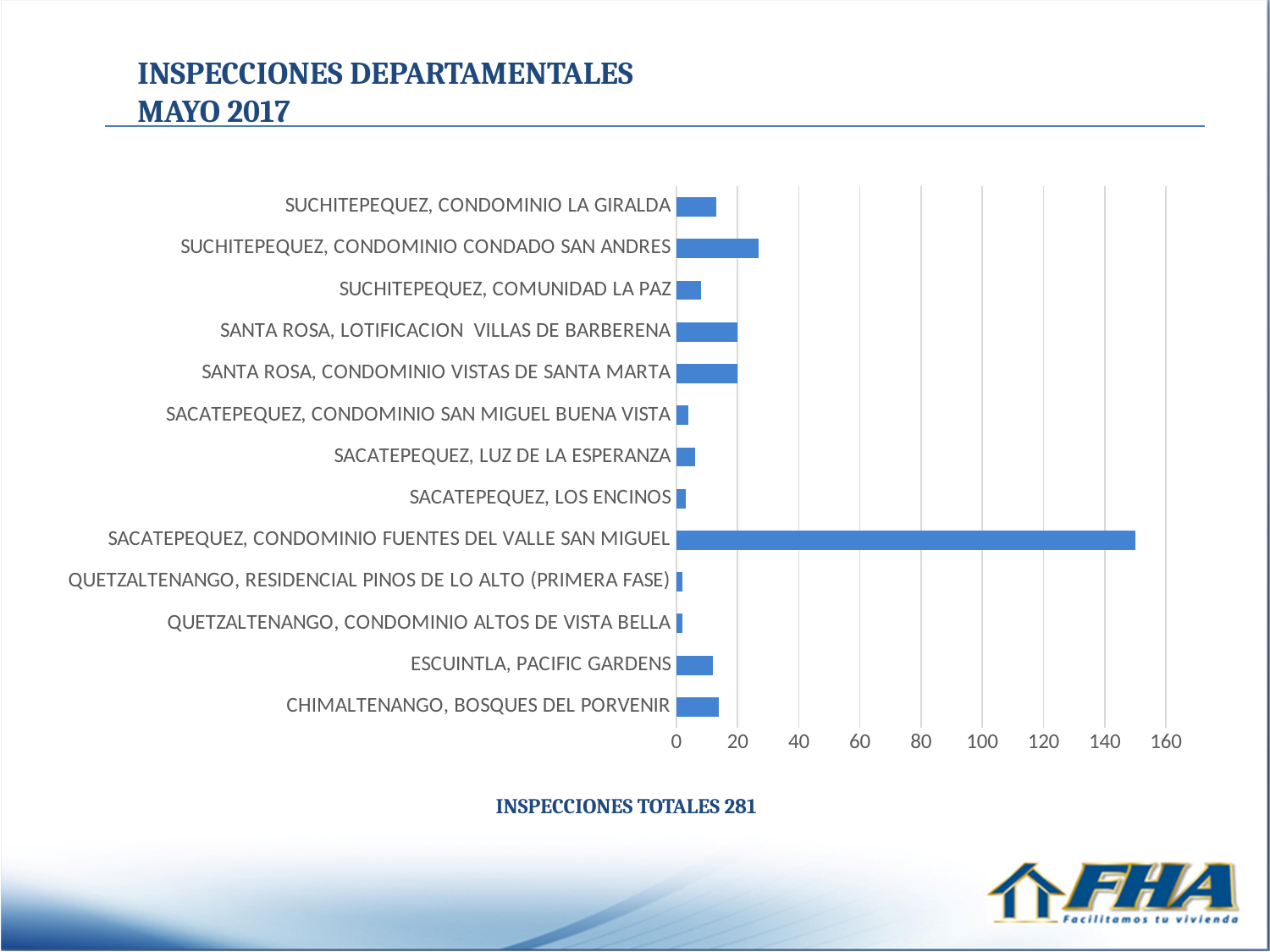
What kind of chart is shown on the slide? Bar chart Which has a larger value: SUCHITEPEQUEZ, CONDOMINIO CONDADO SAN ANDRES or SUCHITEPEQUEZ, CONDOMINIO LA GIRALDA? SUCHITEPEQUEZ, CONDOMINIO CONDADO SAN ANDRES Is the value for ESCUINTLA, PACIFIC GARDENS greater or less than 20? less Which has a larger value: CHIMALTENANGO, BOSQUES DEL PORVENIR or SACATEPEQUEZ, LOS ENCINOS? CHIMALTENANGO, BOSQUES DEL PORVENIR Is the value for SUCHITEPEQUEZ, CONDOMINIO CONDADO SAN ANDRES greater or less than 20? greater Is the value for SACATEPEQUEZ, CONDOMINIO FUENTES DEL VALLE SAN MIGUEL greater or less than 140? greater Which category has the highest number of inspections? SACATEPEQUEZ, CONDOMINIO FUENTES DEL VALLE SAN MIGUEL What is the title of the slide containing the chart? INSPECCIONES DEPARTAMENTALES MAYO 2017 Which has a larger value: SANTA ROSA, LOTIFICACION VILLAS DE BARBERENA or SUCHITEPEQUEZ, COMUNIDAD LA PAZ? SANTA ROSA, LOTIFICACION VILLAS DE BARBERENA How many categories (projects) are plotted in the chart? 13 What total number of inspections is stated below the chart? 281